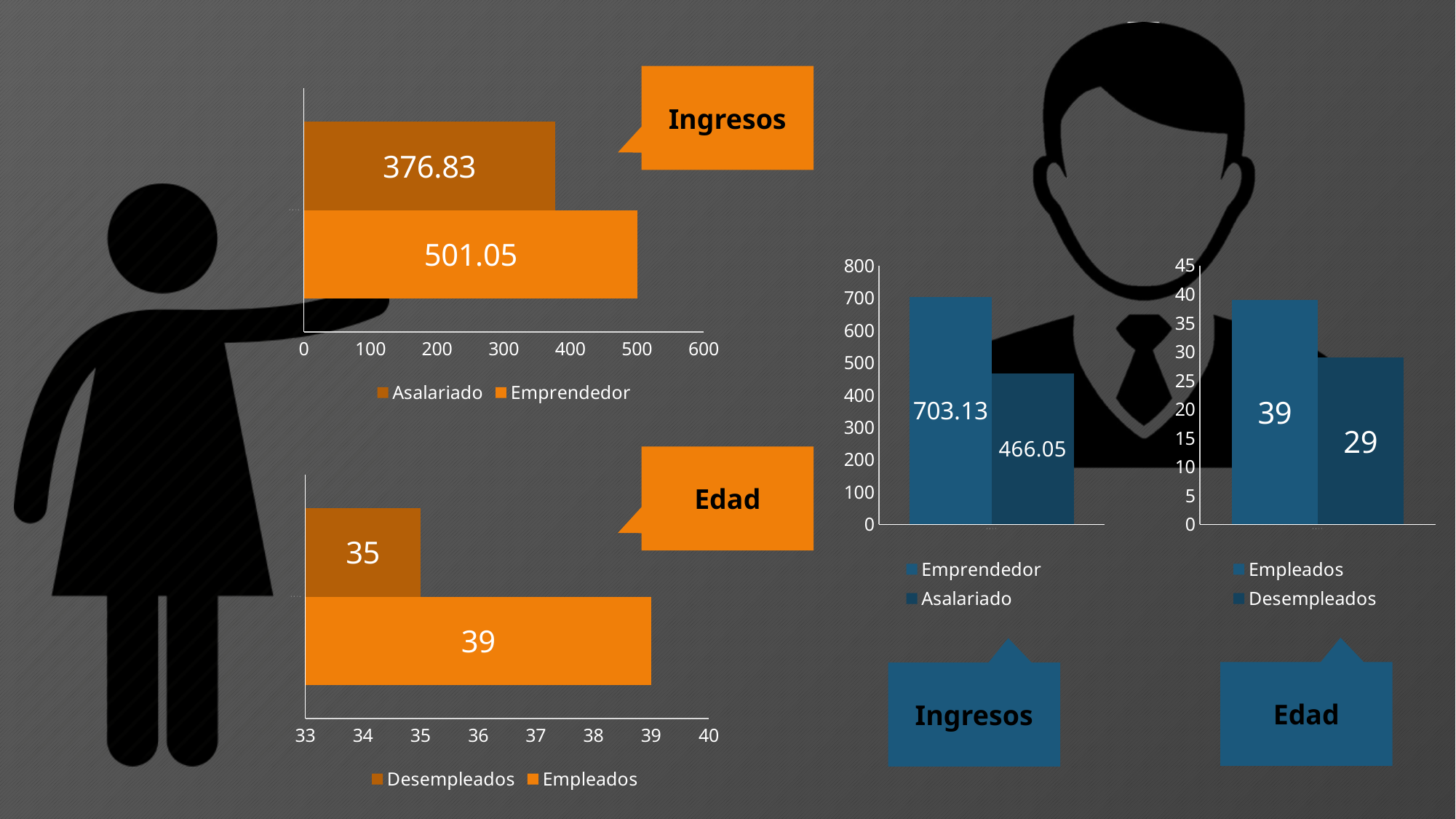
In the orange Edad chart on the left, what is the value for Desempleados? 35 In the blue Ingresos chart on the right, what is the value for Asalariado? 466.05 In the orange Ingresos chart on the left, what is the value for Asalariado? 376.83 What kind of chart is the blue Ingresos chart on the right? Bar chart In the blue Ingresos chart on the right, what is the value for Emprendedor? 703.13 In the orange Ingresos chart on the left, what is the value for Emprendedor? 501.05 In the orange Ingresos chart on the left, what is the difference between the Emprendedor and Asalariado values? 124.22 In the blue Edad chart on the right, what is the value for Desempleados? 29 In the blue Ingresos chart on the right, what is the difference between the Emprendedor and Asalariado values? 237.08 In the orange Edad chart on the left, which series has the higher value? Empleados How many series does the legend of the orange Edad chart on the left list? 2 In the blue Edad chart on the right, what is the difference between Empleados and Desempleados? 10